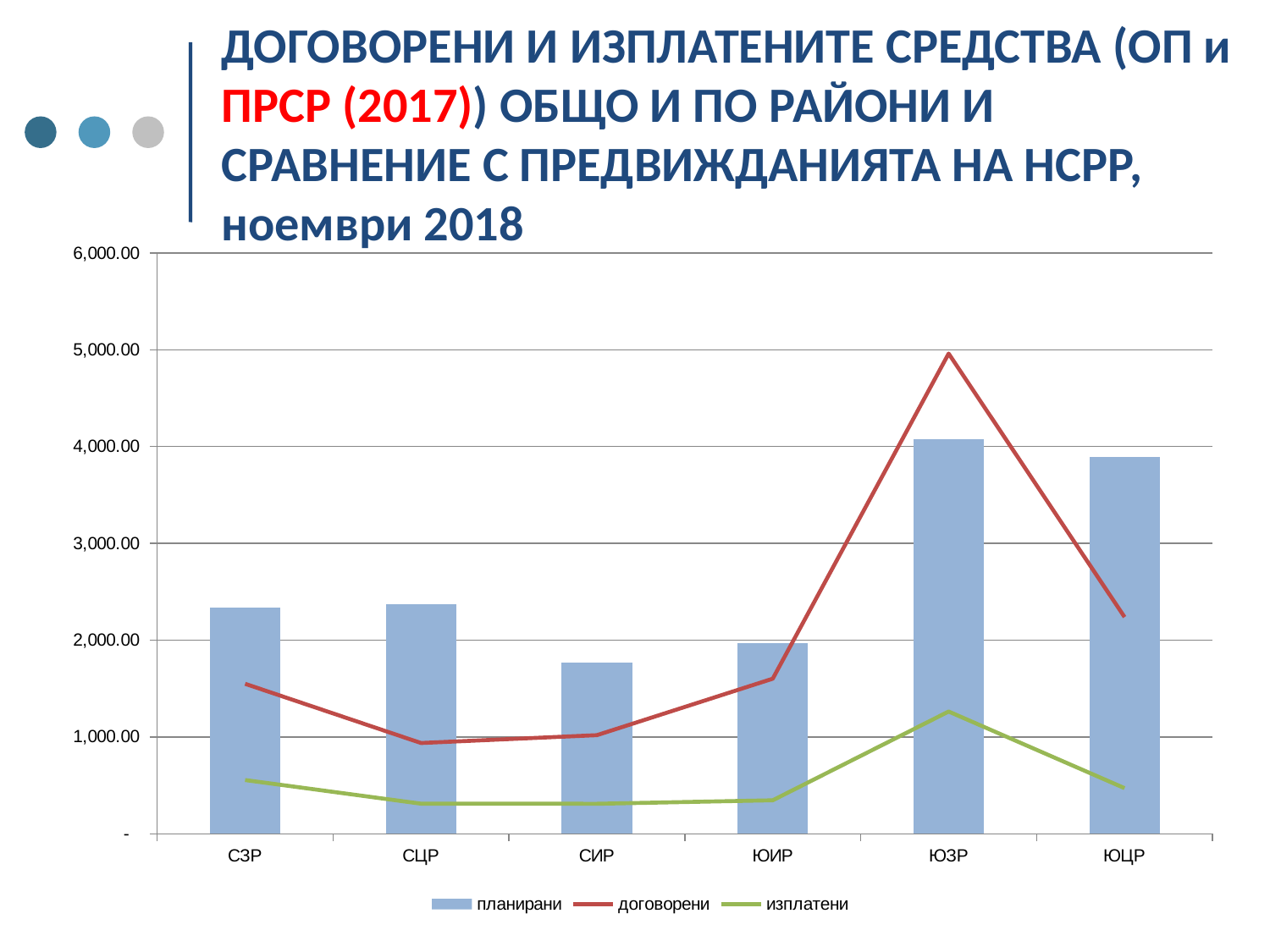
Which region has the highest value for изплатени? ЮЗР Which region has the highest value for планирани? ЮЗР Which series is shown as bars in the chart? планирани Is the value for планирани in СИР greater or less than 2,000.00? less Is the value for изплатени in СЗР greater or less than 1,000.00? less How many series does the chart legend list? 3 How many regions (categories) are shown on the x axis of the chart? 6 Is the value for договорени in ЮЗР greater or less than 4,000.00? greater In ЮЗР, which is larger: планирани or договорени? договорени What kind of chart is shown on the slide? Combined bar and line chart Which region has the highest value for договорени? ЮЗР Which region has the lowest value for планирани? СИР